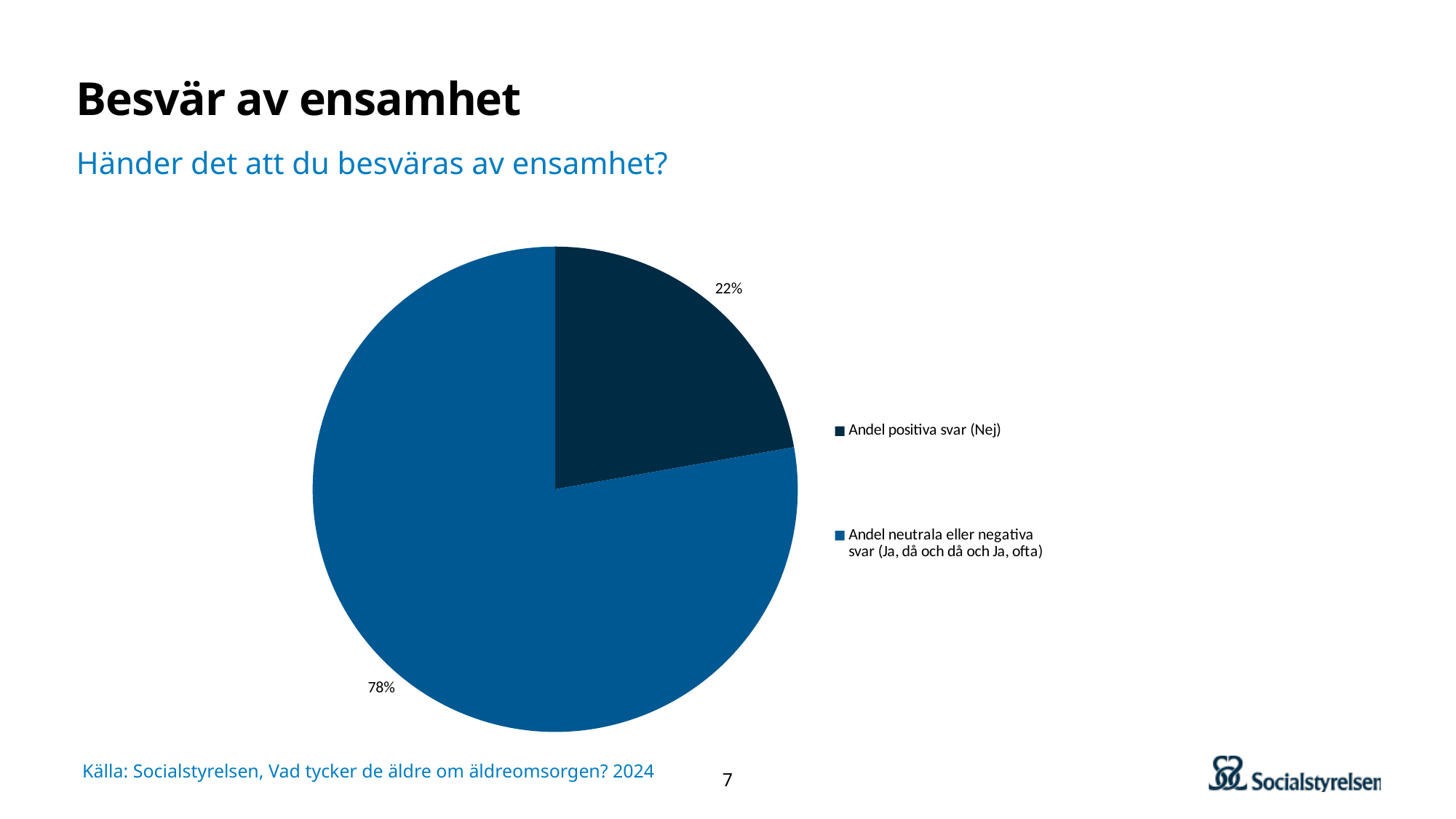
Which slice of the pie is the largest? Andel neutrala eller negativa svar (Ja, då och då och Ja, ofta) What share of the pie is labelled "Andel neutrala eller negativa svar (Ja, då och då och Ja, ofta)"? 78% What question is shown as the chart's subtitle? Händer det att du besväras av ensamhet? What is the difference in percentage points between the "Andel neutrala eller negativa svar" slice and the "Andel positiva svar (Nej)" slice? 56 percentage points How many slices does the pie chart have? 2 Which is larger: the share of "Andel positiva svar (Nej)" or the share of "Andel neutrala eller negativa svar"? Andel neutrala eller negativa svar How many entries does the legend list? 2 What kind of chart is shown on the slide? pie chart What is the source cited at the bottom of the slide? Socialstyrelsen, Vad tycker de äldre om äldreomsorgen? 2024 Which slice of the pie is the smallest? Andel positiva svar (Nej) Is the share of "Andel positiva svar (Nej)" greater or less than 50%? less What share of the pie is labelled "Andel positiva svar (Nej)"? 22%